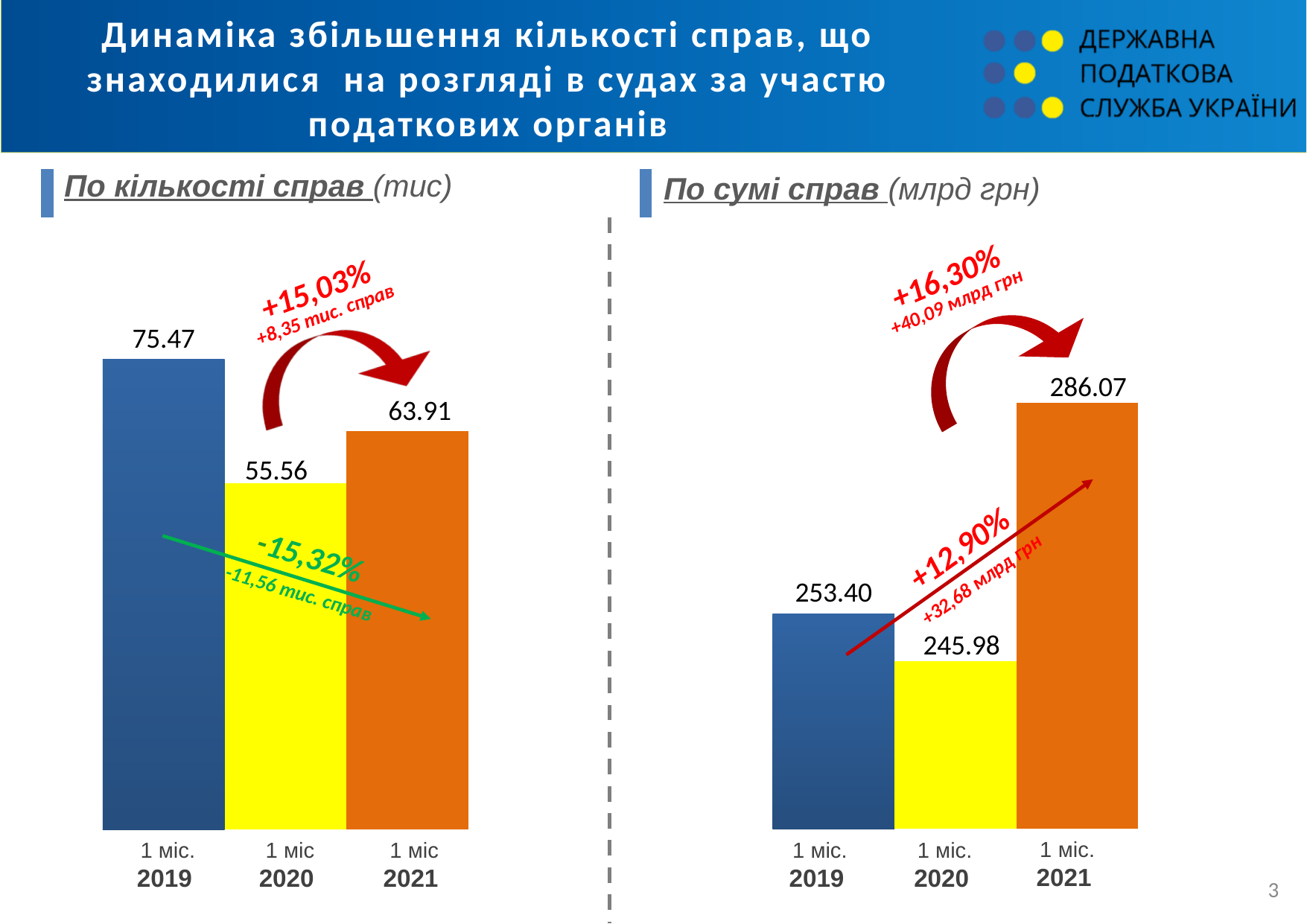
How many bars are in the chart 'По кількості справ (тис)'? 3 What kind of chart is 'По сумі справ (млрд грн)'? bar chart In the chart 'По сумі справ (млрд грн)', what is the difference between the values for 2021 and 2020? 40.09 In the chart 'По кількості справ (тис)', what percentage change is shown between 2020 and 2021? +15,03% In the chart 'По сумі справ (млрд грн)', which year has the lowest value? 2020 In the chart 'По кількості справ (тис)', what is the value for 1 міс 2020? 55.56 In the chart 'По сумі справ (млрд грн)', what is the value for 1 міс. 2020? 245.98 In the chart 'По кількості справ (тис)', what is the value for 1 міс. 2019? 75.47 In the chart 'По кількості справ (тис)', which year has the highest value? 2019 In the chart 'По кількості справ (тис)', what is the difference between the values for 2019 and 2020? 19.91 In the chart 'По сумі справ (млрд грн)', what is the value for 1 міс. 2021? 286.07 In the chart 'По сумі справ (млрд грн)', which is larger, the value for 2019 or the value for 2021? 2021